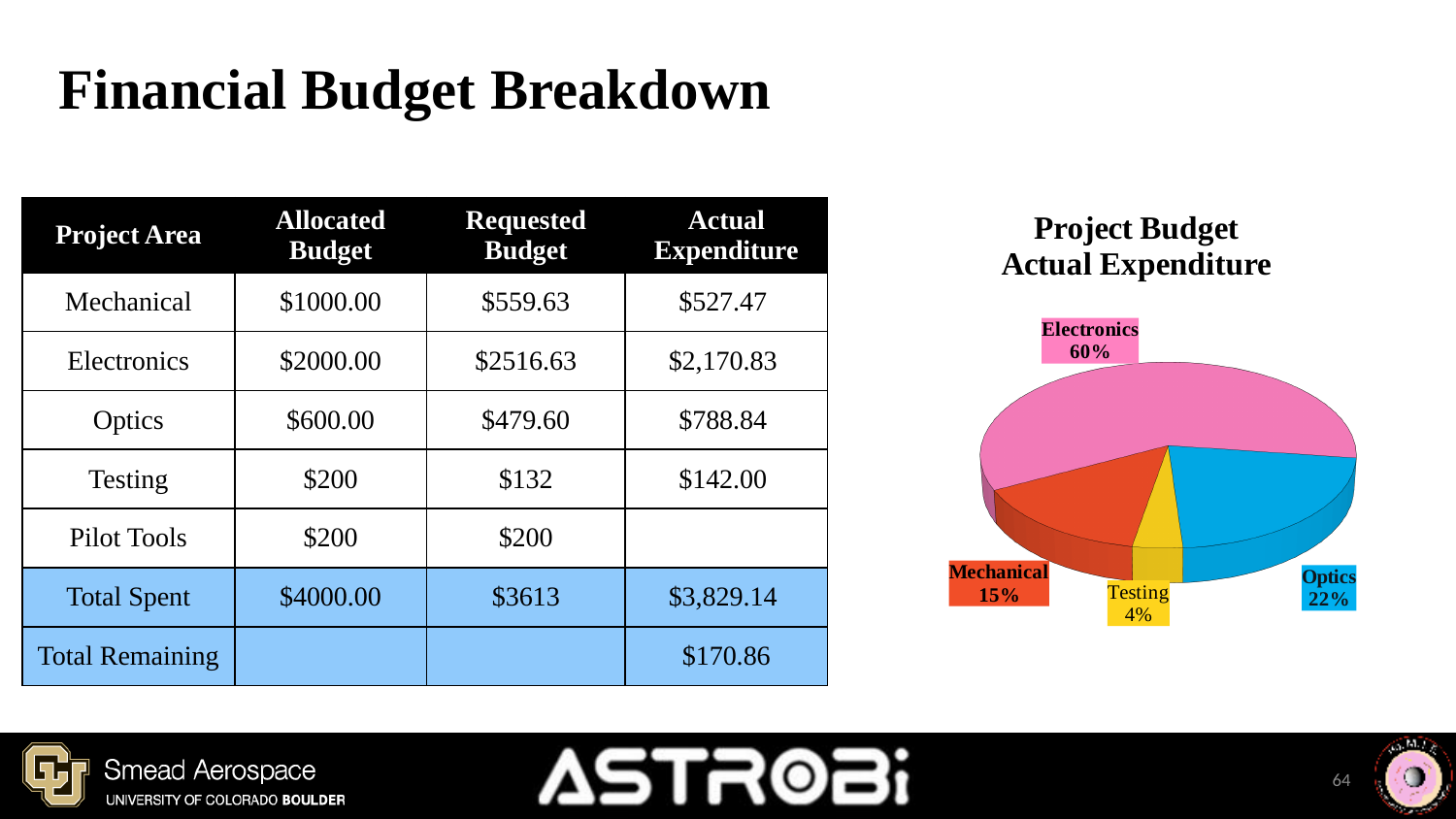
What share of the pie does Mechanical represent? 15% What share of the pie does Electronics represent? 60% Which slice of the pie chart is the smallest? Testing What share of the pie does Testing represent? 4% Which slice of the pie chart is the largest? Electronics What kind of chart is shown on the slide? Pie chart What is the difference in percentage points between the Electronics and Optics slices? 38 What is the title of the pie chart? Project Budget Actual Expenditure What colour is the Electronics slice in the pie chart? Pink How many slices does the pie chart have? 4 Which is larger in the pie chart, Optics or Mechanical? Optics